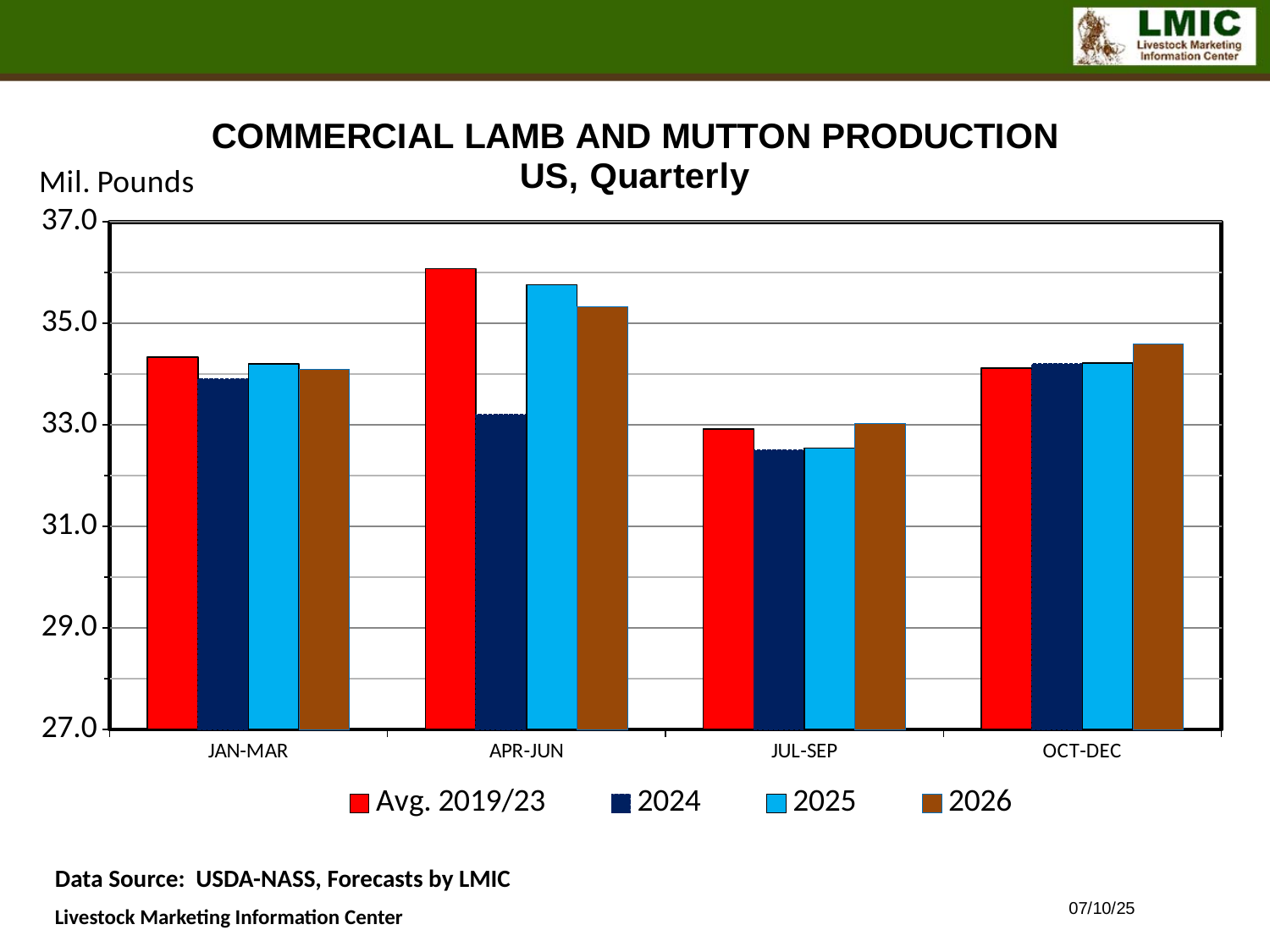
What unit is shown on the y axis of the chart? Mil. Pounds Is the 2024 value for APR-JUN greater or less than 35.0? less Is the 2024 value for JUL-SEP greater or less than 33.0? less Is the Avg. 2019/23 value for APR-JUN greater or less than 35.0? greater How many quarters are shown on the x axis? 4 How many series does the legend list? 4 In APR-JUN, which is larger: the Avg. 2019/23 value or the 2024 value? Avg. 2019/23 In OCT-DEC, which series has the highest bar? 2026 What kind of chart is shown on the slide? Bar chart In which quarter is the 2024 bar the lowest? JUL-SEP In which quarter is the Avg. 2019/23 bar the highest? APR-JUN In APR-JUN, which is larger: the 2025 value or the 2026 value? 2025